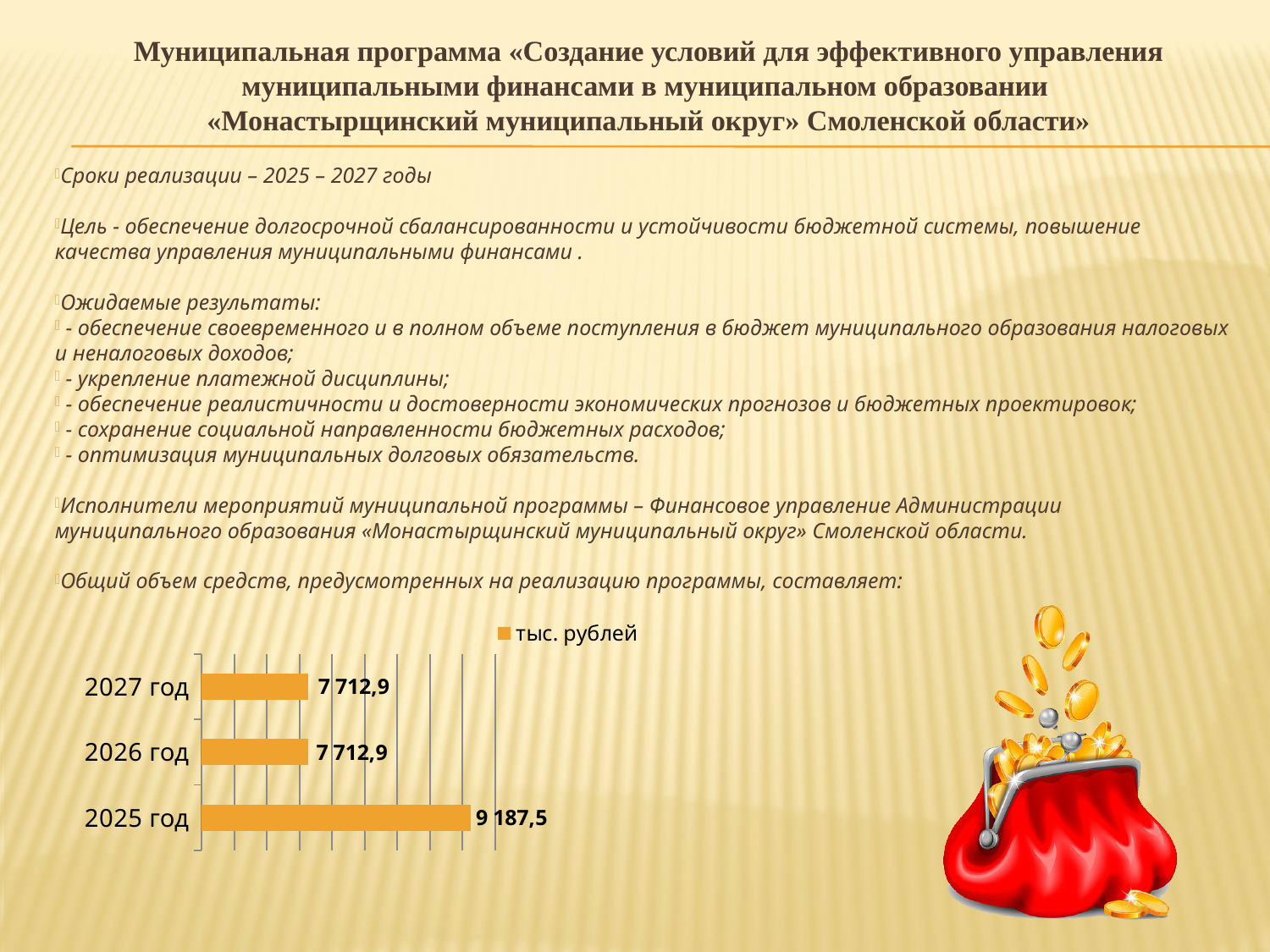
What is the value for 2027 год in the chart? 7 712,9 What kind of chart is shown on the slide? bar chart Which is larger, the value for 2025 год or the value for 2027 год? 2025 год What is the value for 2025 год in the chart? 9 187,5 How many series does the chart legend list? 1 Which year has the highest value in the chart? 2025 год Are the values for 2026 год and 2027 год the same or different? the same Does the value rise or fall from 2025 год to 2026 год? fall How many categories (years) are shown in the chart? 3 What is the difference between the values for 2025 год and 2026 год? 1 474,6 What is the legend entry of the chart? тыс. рублей What is the value for 2026 год in the chart? 7 712,9